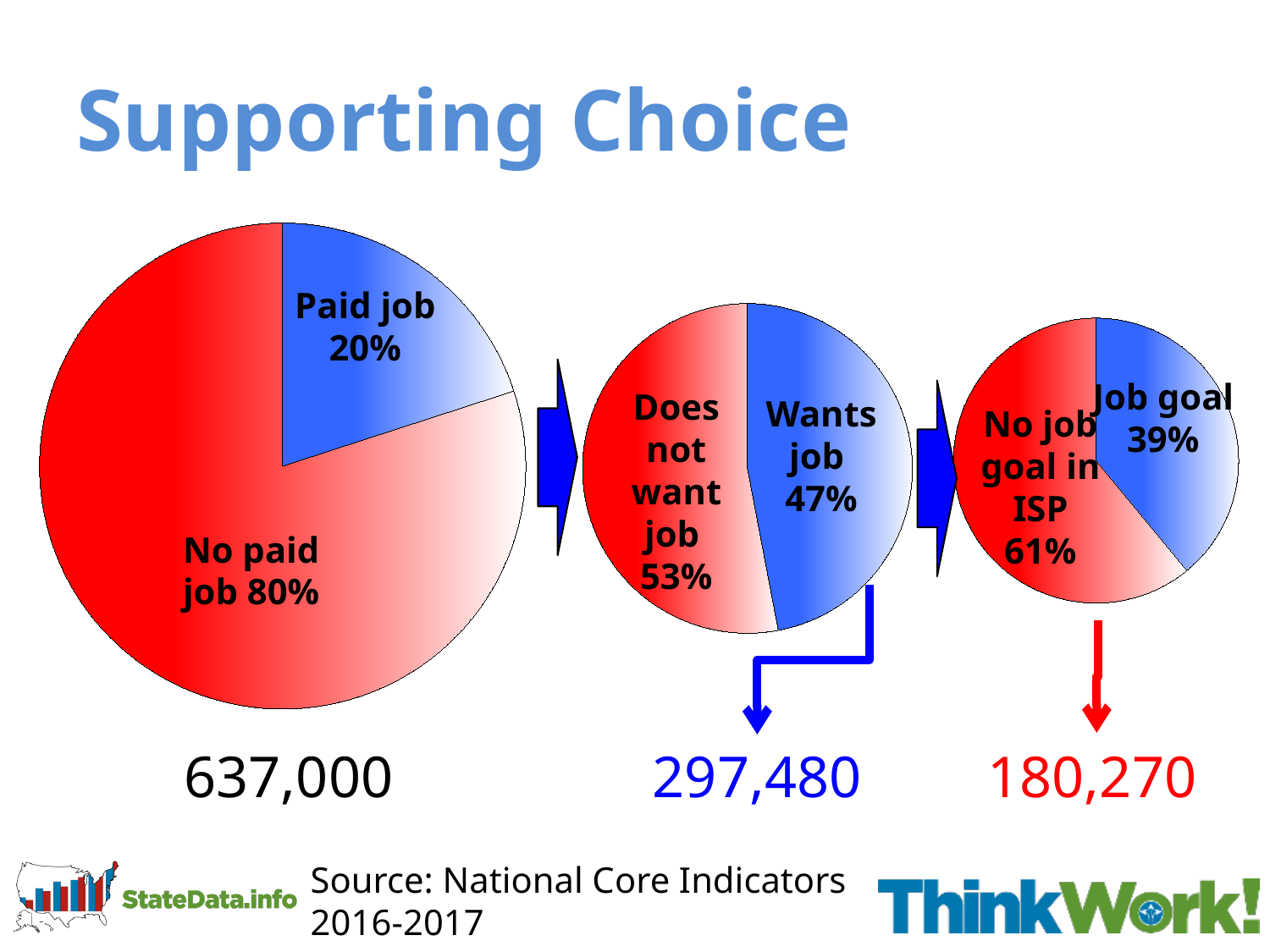
In the left pie chart, what is the difference in percentage points between 'No paid job' and 'Paid job'? 60 In the middle pie chart, which slice is the largest? Does not want job In the middle pie chart, what share is labelled 'Does not want job'? 53% What number is printed below the middle pie chart? 297,480 In the left pie chart, which slice is larger, 'Paid job' or 'No paid job'? No paid job In the middle pie chart, what share is labelled 'Wants job'? 47% In the right pie chart, what share is labelled 'No job goal in ISP'? 61% In the right pie chart, which slice is the smallest? Job goal How many pie charts are shown on the slide? 3 In the left pie chart, what share is labelled 'Paid job'? 20% In the right pie chart, what share is labelled 'Job goal'? 39% In the left pie chart, what share is labelled 'No paid job'? 80%